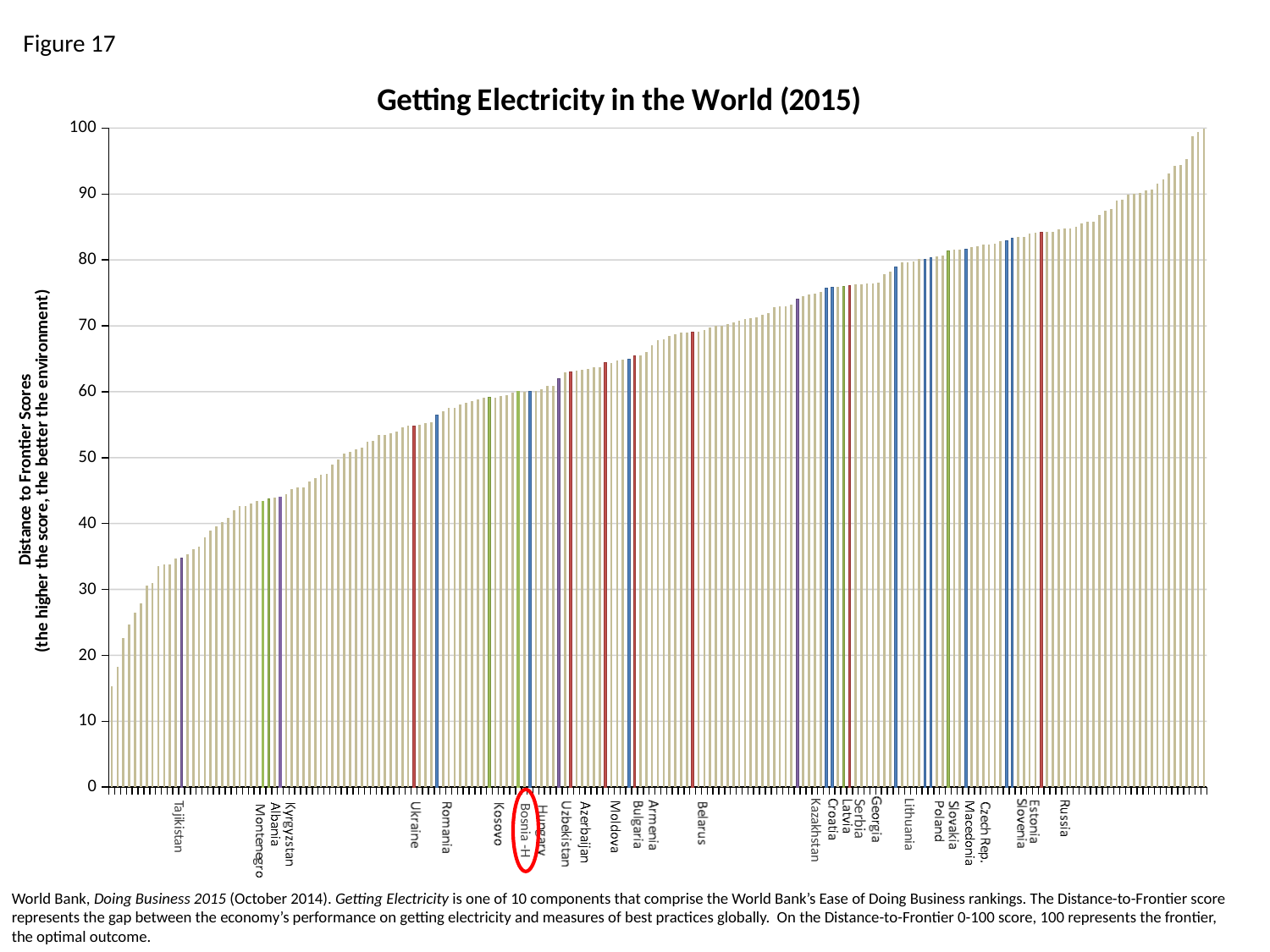
Is the value for Belarus greater or less than 70? less Which has the larger value, Ukraine or Belarus? Belarus Which has the larger value, Tajikistan or Russia? Russia Do the bar values rise or fall from left to right along the x axis? rise Is the value for Tajikistan greater or less than 40? less Is the value for Ukraine greater or less than 50? greater Among the labeled countries, which has the lowest value? Tajikistan Which country label is circled in red on the chart? Bosnia -H What is the title of the chart? Getting Electricity in the World (2015) What kind of chart is shown on the slide? bar chart